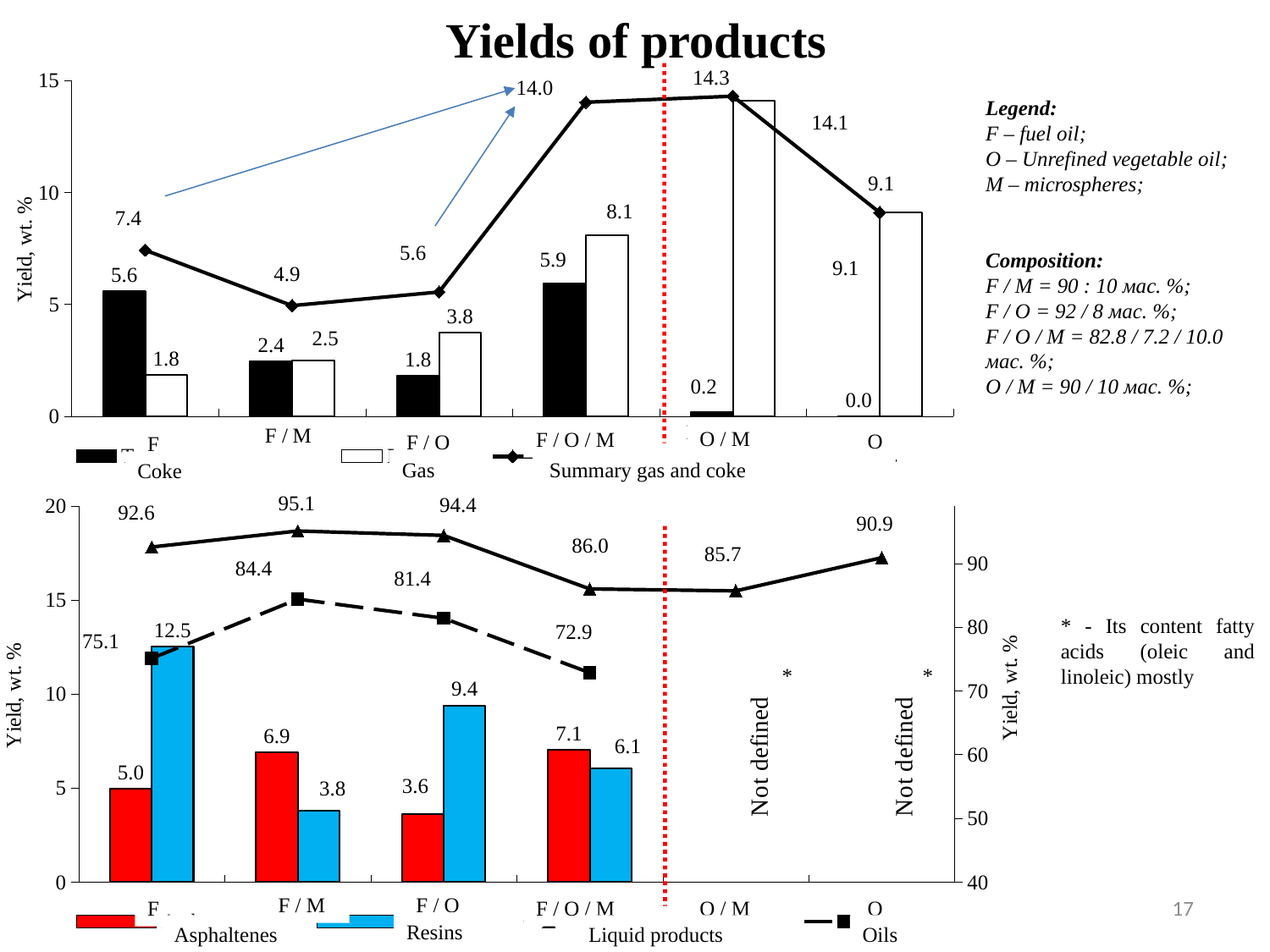
What is the title of the slide's charts? Yields of products In the bottom chart, how many categories are shown on the x axis? 6 In the bottom chart, what is the Liquid products value for F / M? 95.1 In the top chart, what is the Gas yield for O / M? 14.1 In the bottom chart, is the Asphaltenes yield for F / O / M larger or smaller than the Resins yield for F / O / M? larger In the top chart, which category has the highest Summary gas and coke value? O / M In the top chart, which category has the lowest Coke yield? O In the top chart, what is the difference between the Gas yield and the Coke yield for F / O / M? 2.2 In the top chart, how many series does the legend list? 3 In the bottom chart, which category has the highest Oils value? F / M In the bottom chart, what is the Resins yield for F / O? 9.4 In the top chart, what is the Coke yield for F / O / M? 5.9